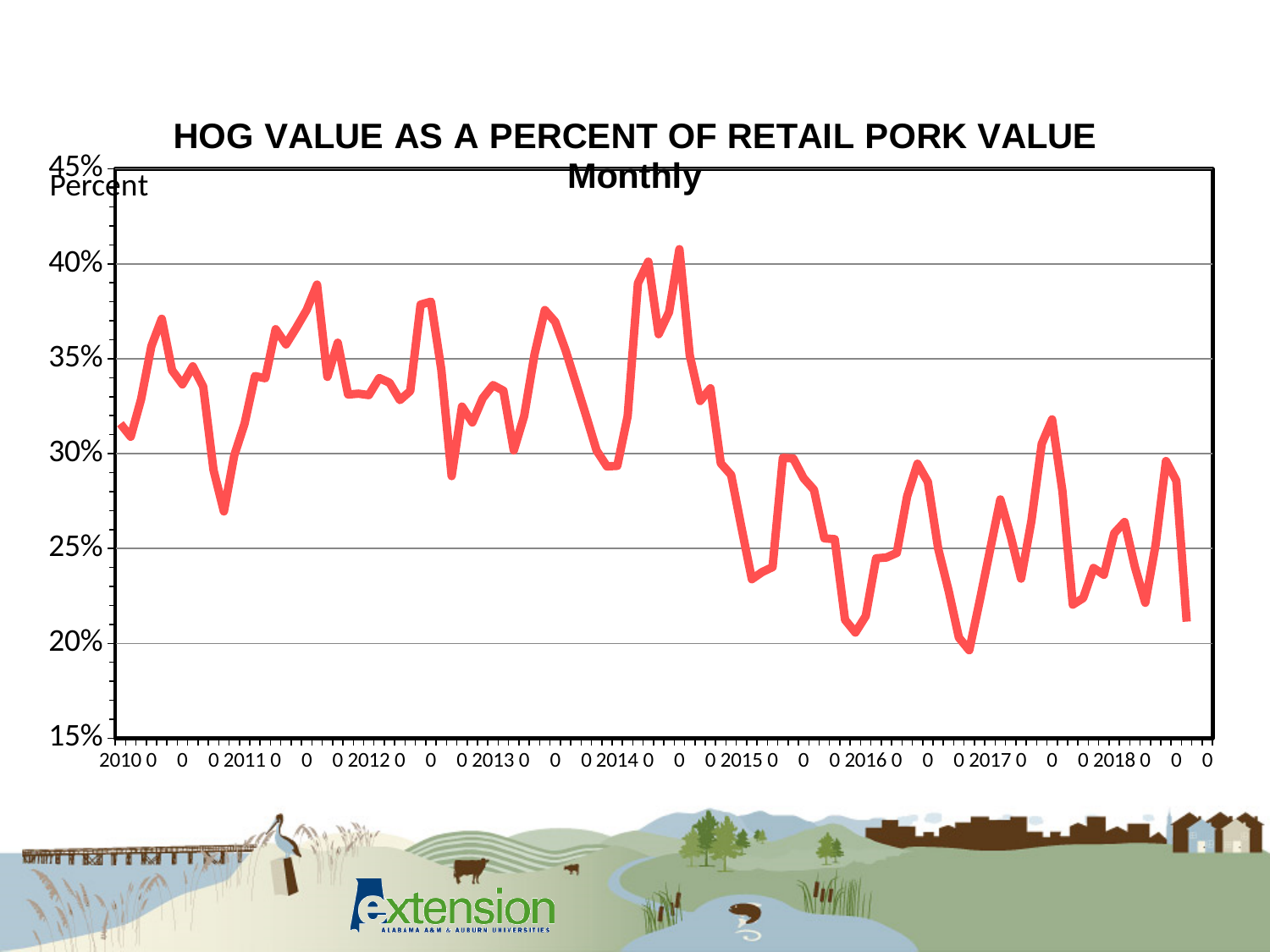
What is the title of the chart? HOG VALUE AS A PERCENT OF RETAIL PORK VALUE Monthly Is the value at the start of 2012 greater or less than 30%? greater Which is larger: the peak value in 2014 or the peak value in 2017? peak in 2014 What label is shown on the vertical axis of the chart? Percent Is the value at the start of 2016 greater or less than 25%? less How many years are labeled on the x axis? 9 Overall, does the hog value as a percent of retail pork value rise or fall from 2010 to 2018? fall Which is larger: the value at the start of 2010 or the value at the start of 2018? start of 2010 What kind of chart is shown on the slide? line chart Is the value at the start of 2010 greater or less than 25%? greater